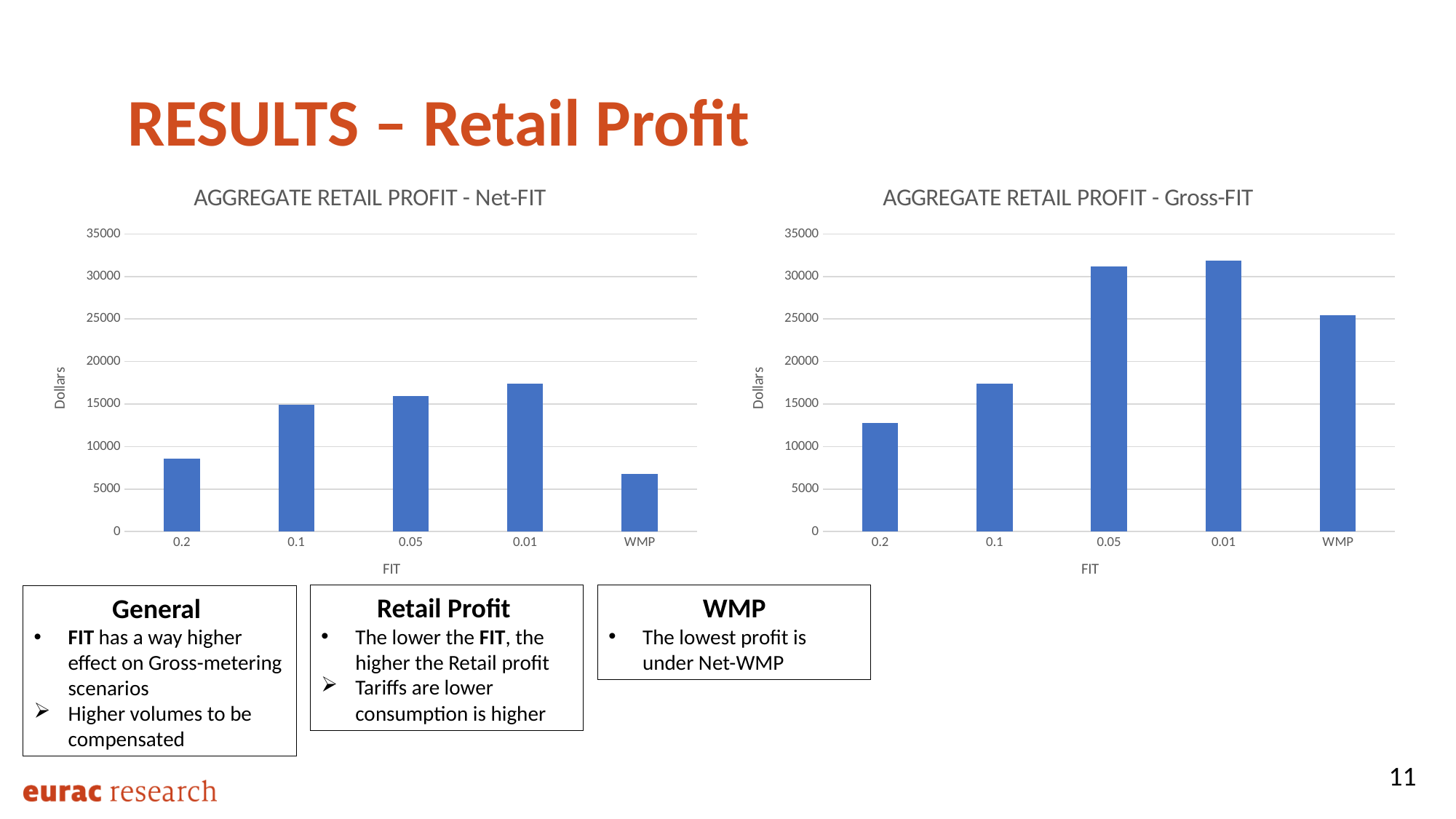
In the "AGGREGATE RETAIL PROFIT - Gross-FIT" chart, is the value for 0.05 greater or less than 30000? greater In the "AGGREGATE RETAIL PROFIT - Net-FIT" chart, which category has the lowest bar? WMP In the "AGGREGATE RETAIL PROFIT - Gross-FIT" chart, which category has the lowest bar? 0.2 How many categories are shown on the x axis of the "AGGREGATE RETAIL PROFIT - Gross-FIT" chart? 5 In the "AGGREGATE RETAIL PROFIT - Net-FIT" chart, which is larger, the value for 0.1 or the value for WMP? 0.1 In the "AGGREGATE RETAIL PROFIT - Net-FIT" chart, is the value for 0.2 greater or less than 10000? less In the "AGGREGATE RETAIL PROFIT - Gross-FIT" chart, is the value for WMP greater or less than 20000? greater What kind of chart is the "AGGREGATE RETAIL PROFIT - Net-FIT" chart? Bar chart In the "AGGREGATE RETAIL PROFIT - Gross-FIT" chart, do the values rise or fall from the 0.2 category to the 0.01 category? Rise In the "AGGREGATE RETAIL PROFIT - Gross-FIT" chart, which is larger, the value for 0.1 or the value for WMP? WMP What is the label on the vertical axis of the "AGGREGATE RETAIL PROFIT - Net-FIT" chart? Dollars In the "AGGREGATE RETAIL PROFIT - Net-FIT" chart, which category has the highest bar? 0.01